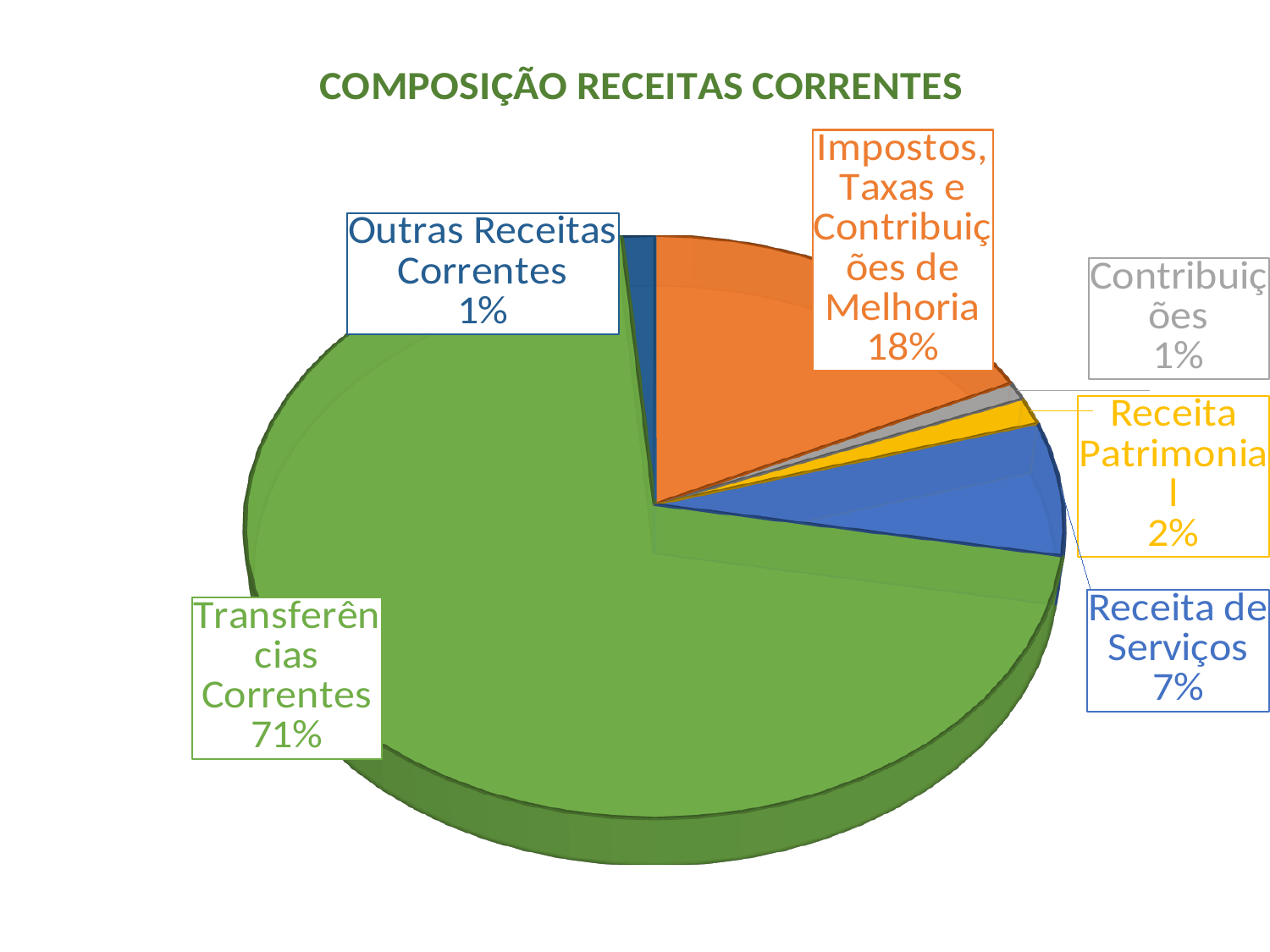
Which is larger, Receita de Serviços or Receita Patrimonial? Receita de Serviços What colour is the Transferências Correntes slice? green Which category has the largest share of the pie? Transferências Correntes What kind of chart is shown on the slide? pie chart What is the title of the chart? COMPOSIÇÃO RECEITAS CORRENTES What share of the pie is Receita de Serviços? 7% What is the difference in percentage points between Transferências Correntes and Impostos, Taxas e Contribuições de Melhoria? 53 percentage points What share of the pie is Contribuições? 1% How many slices does the pie chart have? 6 What share of the pie is Receita Patrimonial? 2%